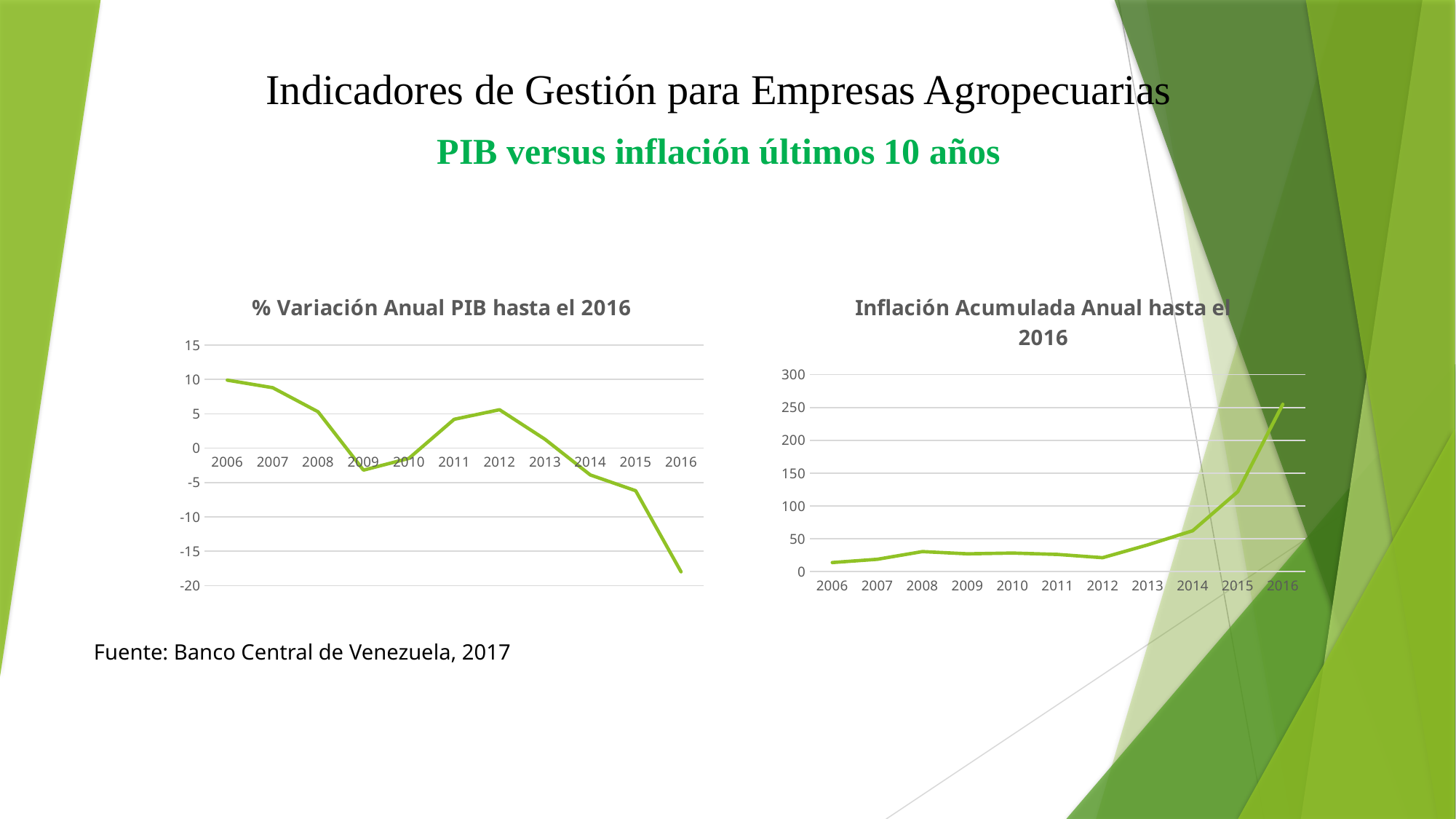
In the '% Variación Anual PIB hasta el 2016' chart, is the value for 2009 greater or less than 0? less What kind of chart is the 'Inflación Acumulada Anual hasta el 2016' chart? line chart In the '% Variación Anual PIB hasta el 2016' chart, how many years are plotted on the x axis? 11 In the '% Variación Anual PIB hasta el 2016' chart, which year has the lowest value? 2016 In the 'Inflación Acumulada Anual hasta el 2016' chart, is the value for 2016 greater or less than 200? greater What kind of chart is the '% Variación Anual PIB hasta el 2016' chart? line chart In the 'Inflación Acumulada Anual hasta el 2016' chart, which year has the lowest value? 2006 In the '% Variación Anual PIB hasta el 2016' chart, which year has the highest value? 2006 In the 'Inflación Acumulada Anual hasta el 2016' chart, how many years are plotted on the x axis? 11 In the 'Inflación Acumulada Anual hasta el 2016' chart, do the values generally rise or fall from 2012 to 2016? rise In the '% Variación Anual PIB hasta el 2016' chart, is the value for 2016 greater or less than -15? less In the 'Inflación Acumulada Anual hasta el 2016' chart, which year has the highest value? 2016